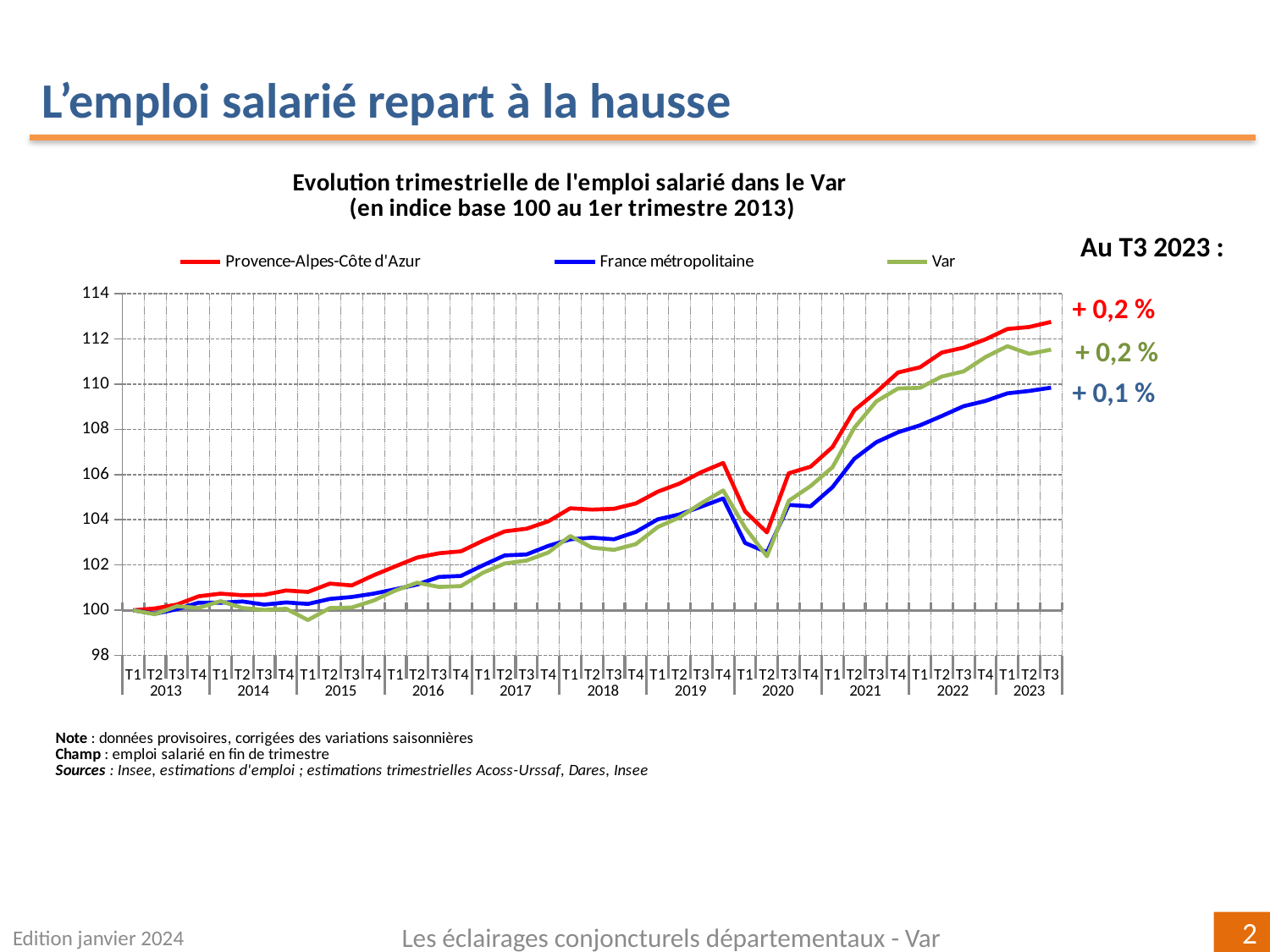
How many years are labelled on the x axis? 11 What kind of chart is shown on the slide? line chart Which series has the lowest value at T3 2023? France métropolitaine Do the values for Provence-Alpes-Côte d'Azur rise or fall between T4 2019 and T2 2020? fall At T3 2023, which is larger: the value for Var or the value for France métropolitaine? Var Is the value for Provence-Alpes-Côte d'Azur at T3 2023 greater or less than 112? greater Is the value for France métropolitaine at T2 2020 greater or less than 104? less How many series does the legend list? 3 Which series are listed in the legend? Provence-Alpes-Côte d'Azur, France métropolitaine, Var Which series has the highest value at T3 2023? Provence-Alpes-Côte d'Azur What is the title of the chart? Evolution trimestrielle de l'emploi salarié dans le Var (en indice base 100 au 1er trimestre 2013)